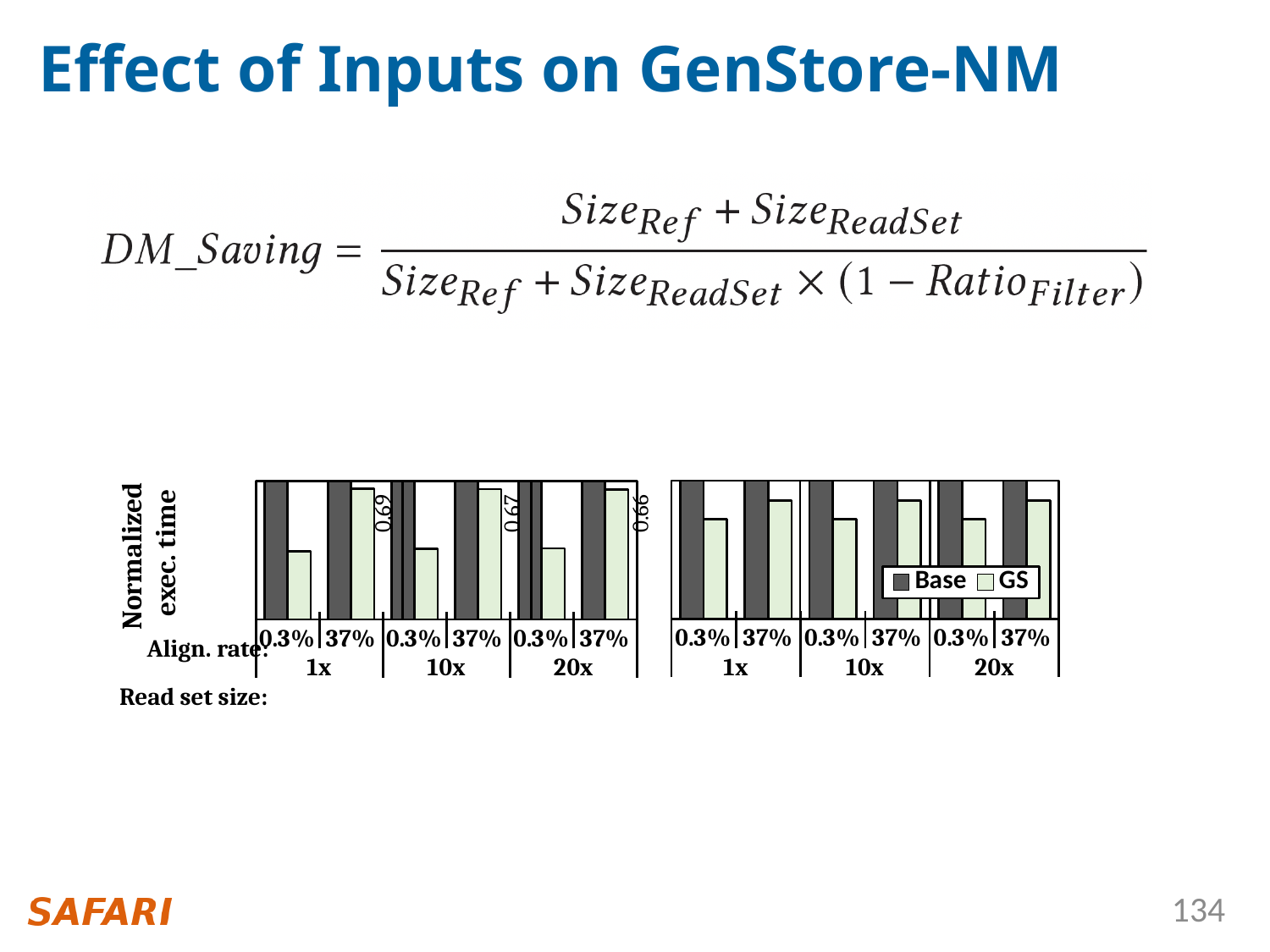
How many read set sizes are shown along the x axis of each chart? 3 In the left chart, what is the difference between the labeled GS values at 37% alignment rate for 1x and 20x read set sizes? 0.03 In the left chart, which read set size has the lowest labeled GS value at 37% alignment rate? 20x In the right chart, for a 0.3% alignment rate and 1x read set size, which is larger, Base or GS? Base What kind of chart is the left chart on the slide? bar chart What are the two series named in the legend? Base and GS In the left chart, for a 1x read set size, is the GS bar larger at 0.3% or at 37% alignment rate? 37% In the left chart, do the labeled GS values at 37% alignment rate rise or fall as the read set size goes from 1x to 20x? fall In the left chart, what is the GS value at a 37% alignment rate with a 1x read set size? 0.69 In the left chart, what is the GS value at a 37% alignment rate with a 10x read set size? 0.67 How many series does the legend list for the charts? 2 In the left chart, what is the GS value at a 37% alignment rate with a 20x read set size? 0.66